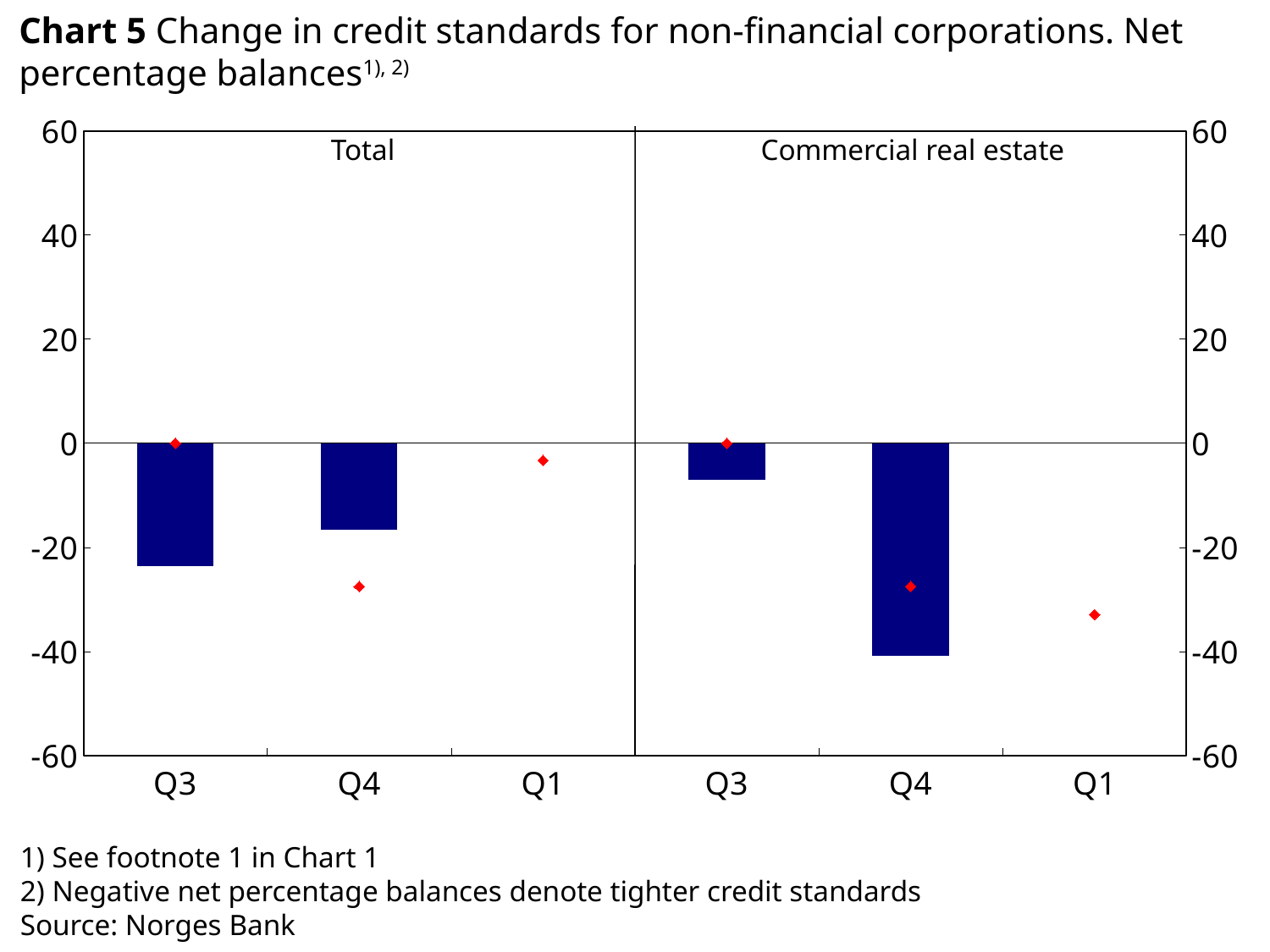
Across both panels, which bar reaches the lowest value? Q4 in Commercial real estate In the Commercial real estate panel, is the bar for Q4 greater or less than -20? less In the Total panel, which bar is lower, Q3 or Q4? Q3 What is the source given for the chart? Norges Bank In the Commercial real estate panel, is the red marker for Q1 greater or less than -20? less In the Commercial real estate panel, which bar is lower, Q3 or Q4? Q4 How many quarters are shown on the x axis of the Total panel? 3 What are the two panels of the chart labelled? Total and Commercial real estate In the Total panel, is the bar for Q4 greater or less than -20? greater What kind of chart is shown on the slide? bar chart